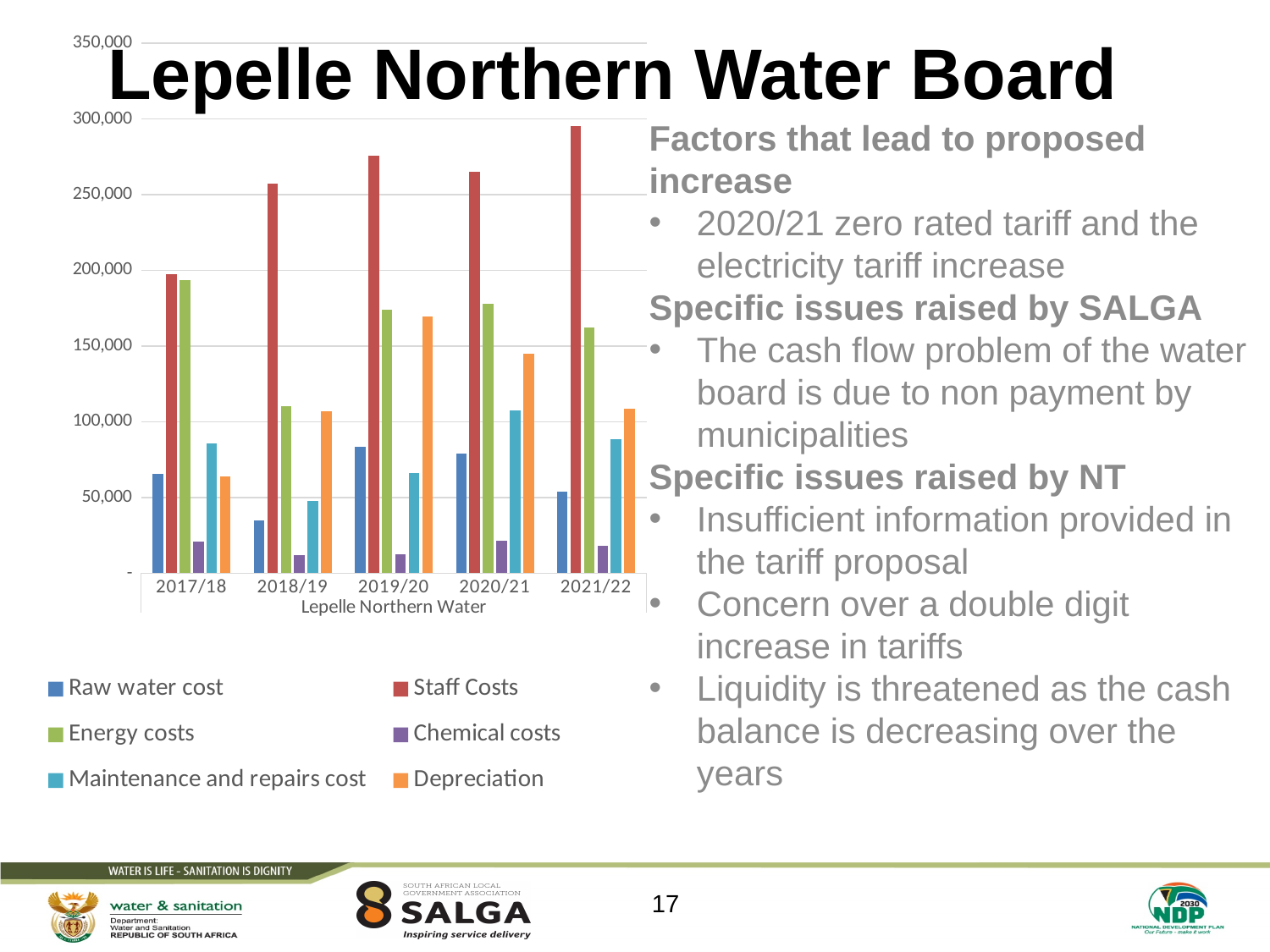
Which cost series is the highest in 2018/19? Staff Costs What type of chart is shown on the slide? Bar chart In which year is the Raw water cost the lowest? 2018/19 In which year are Staff Costs the highest? 2021/22 Is the value for Depreciation in 2019/20 greater or less than 150,000? greater How many series does the chart legend list? 6 What label appears below the year categories on the x axis? Lepelle Northern Water Is the value for Staff Costs in 2021/22 greater or less than 250,000? greater How many financial years are shown on the x axis of the chart? 5 Which cost series is the lowest in 2021/22? Chemical costs Is the value for Energy costs in 2018/19 greater or less than 150,000? less In 2019/20, which is larger: Depreciation or Maintenance and repairs cost? Depreciation